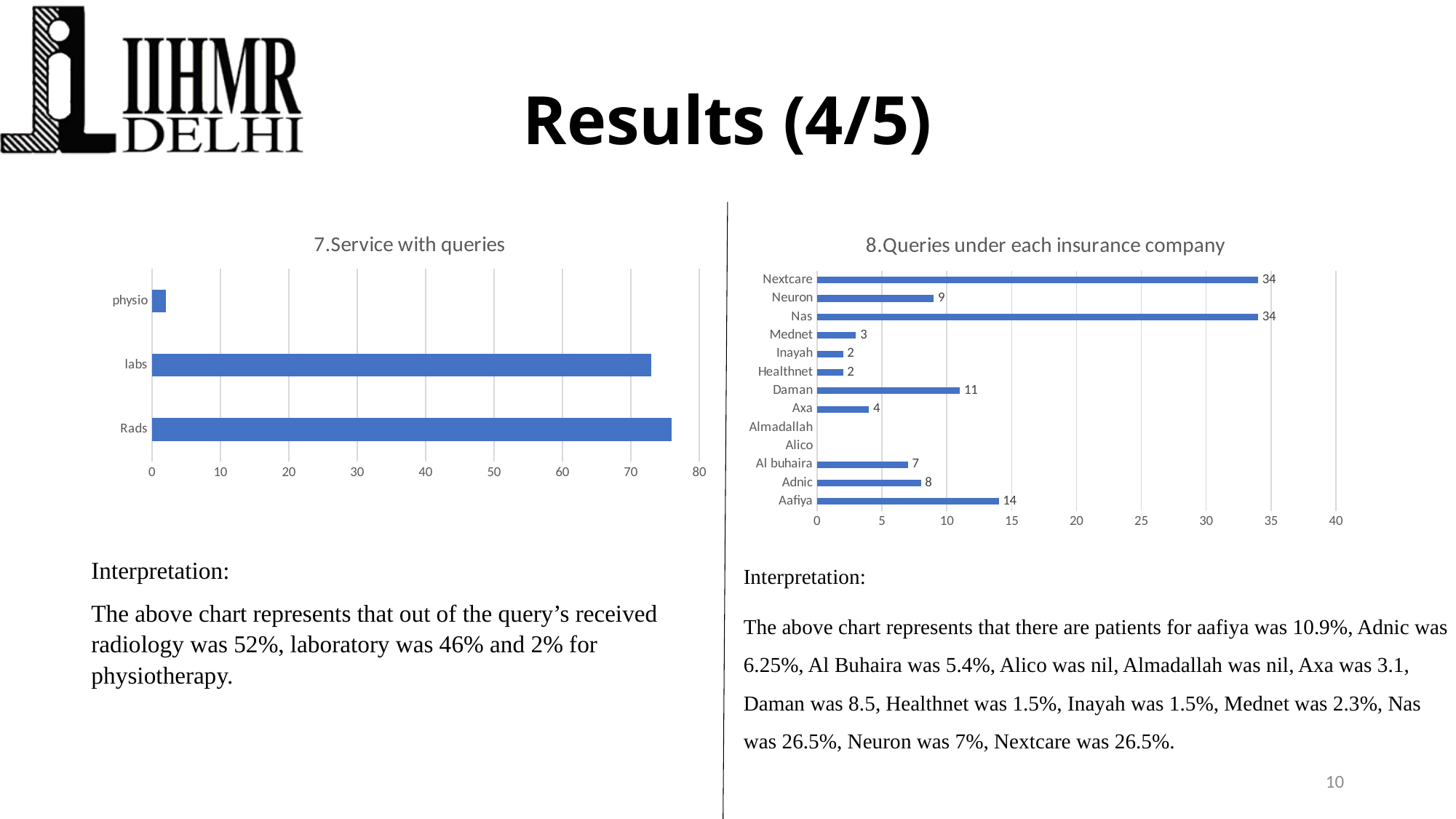
How many insurance companies are listed in the chart titled "8.Queries under each insurance company"? 13 In the chart titled "7.Service with queries", is the value for physio greater or less than 10? less In the chart titled "8.Queries under each insurance company", what is the value for Aafiya? 14 In the chart titled "7.Service with queries", is the value for labs greater or less than 70? greater In the chart titled "8.Queries under each insurance company", what is the value for Al buhaira? 7 In the chart titled "8.Queries under each insurance company", which is larger, the value for Daman or the value for Neuron? Daman How many categories are shown in the chart titled "7.Service with queries"? 3 What kind of chart is the chart titled "7.Service with queries"? bar chart In the chart titled "8.Queries under each insurance company", what is the difference between the values for Aafiya and Daman? 3 In the chart titled "8.Queries under each insurance company", what is the value for Daman? 11 In the chart titled "7.Service with queries", which category has the lowest value? physio In the chart titled "8.Queries under each insurance company", what is the value for Neuron? 9